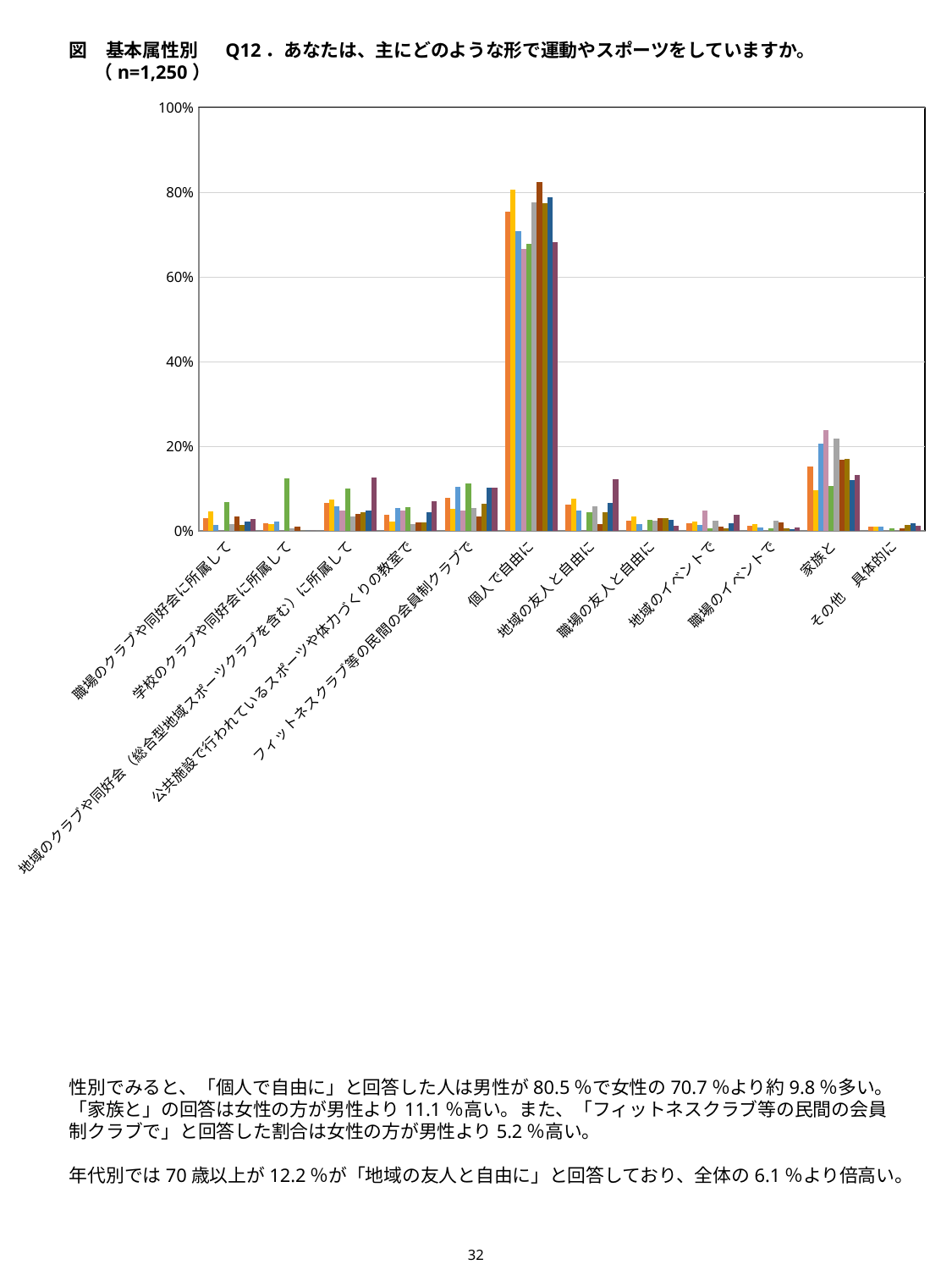
Which category has the tallest bars in the chart? 個人で自由に Are the bars for 個人で自由に greater or less than 60%? greater Which category has taller bars, 個人で自由に or 地域の友人と自由に? 個人で自由に Are the bars for 家族と greater or less than 40%? less What is the sample size (n) stated in the chart title? n=1,250 Which category has taller bars, 家族と or 職場のイベントで? 家族と What is the maximum value shown on the y axis of the chart? 100% What kind of chart is shown on the slide? bar chart How many categories are shown along the x axis of the chart? 12 Are the bars for 職場のイベントで greater or less than 20%? less Which category has taller bars, 個人で自由に or 家族と? 個人で自由に